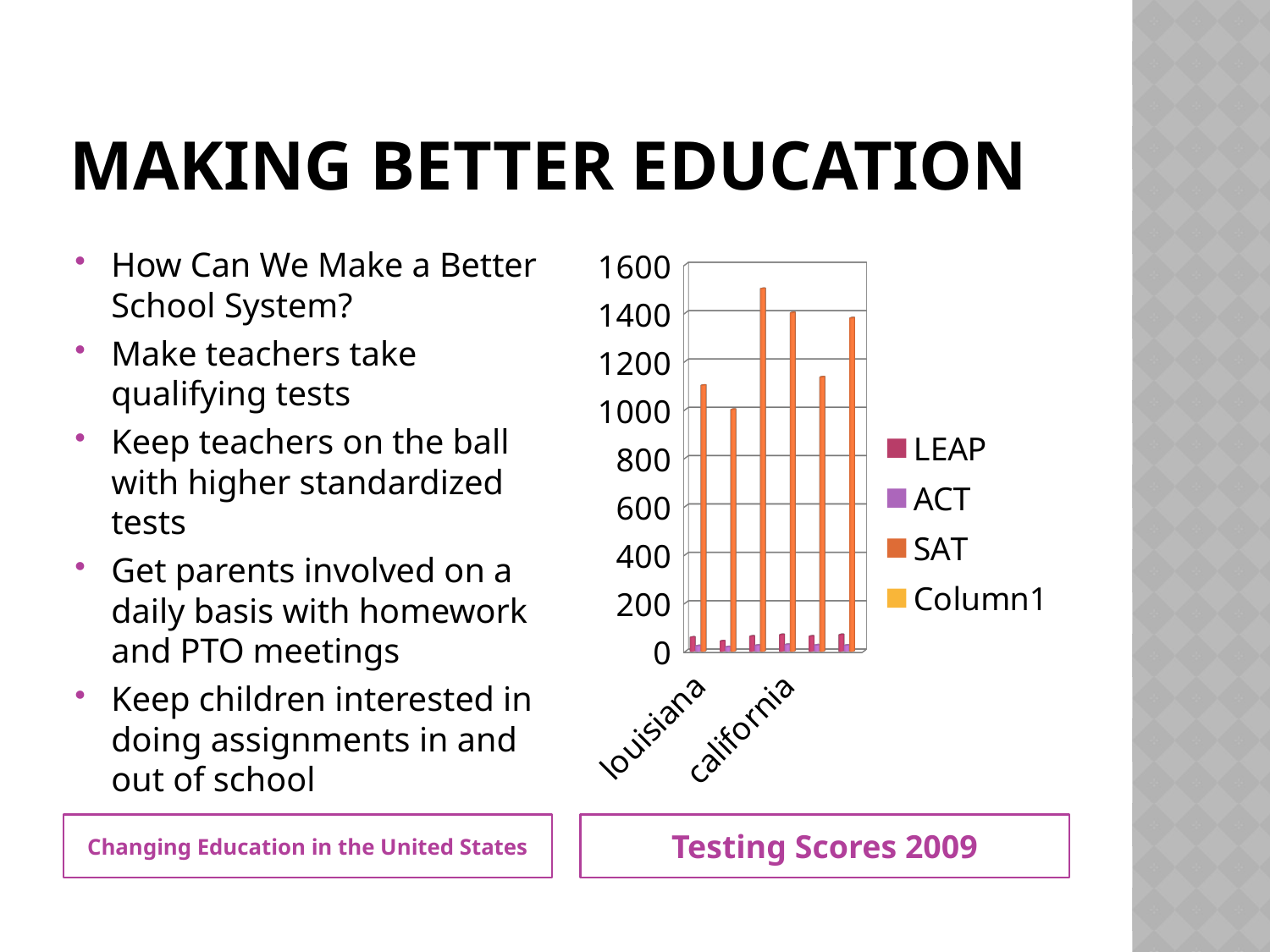
Is the lowest SAT value in the chart greater or less than 1200? less Are all of the SAT values in the chart greater or less than 800? greater Are all of the LEAP values in the chart greater or less than 200? less How many series does the chart's legend list? 4 Which series has the tallest bars in the chart? SAT What is the highest value shown on the chart's vertical axis? 1600 What caption appears in the box below the chart? Testing Scores 2009 What kind of chart is shown on the slide? bar chart